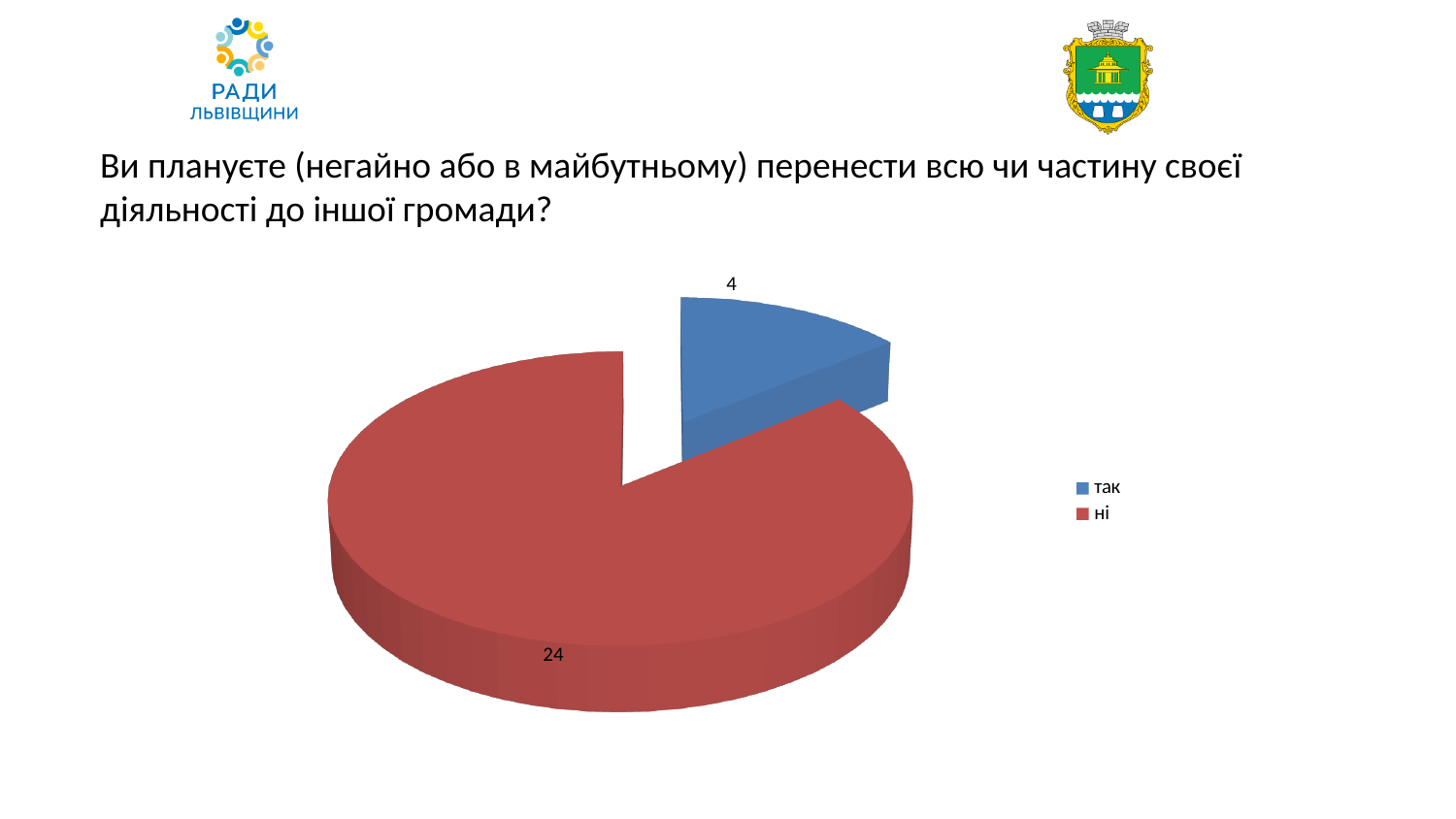
What is the total of all slices in the pie chart? 28 What value is shown for the "так" slice of the pie chart? 4 Which category has the largest slice in the pie chart? ні Which is larger, the value for "так" or the value for "ні"? ні How many entries does the legend list? 2 What colour is the "так" slice in the pie chart? blue What value is shown for the "ні" slice of the pie chart? 24 What kind of chart is shown on the slide? pie chart Which category has the smallest slice in the pie chart? так What is the difference between the values for "ні" and "так"? 20 How many slices does the pie chart have? 2